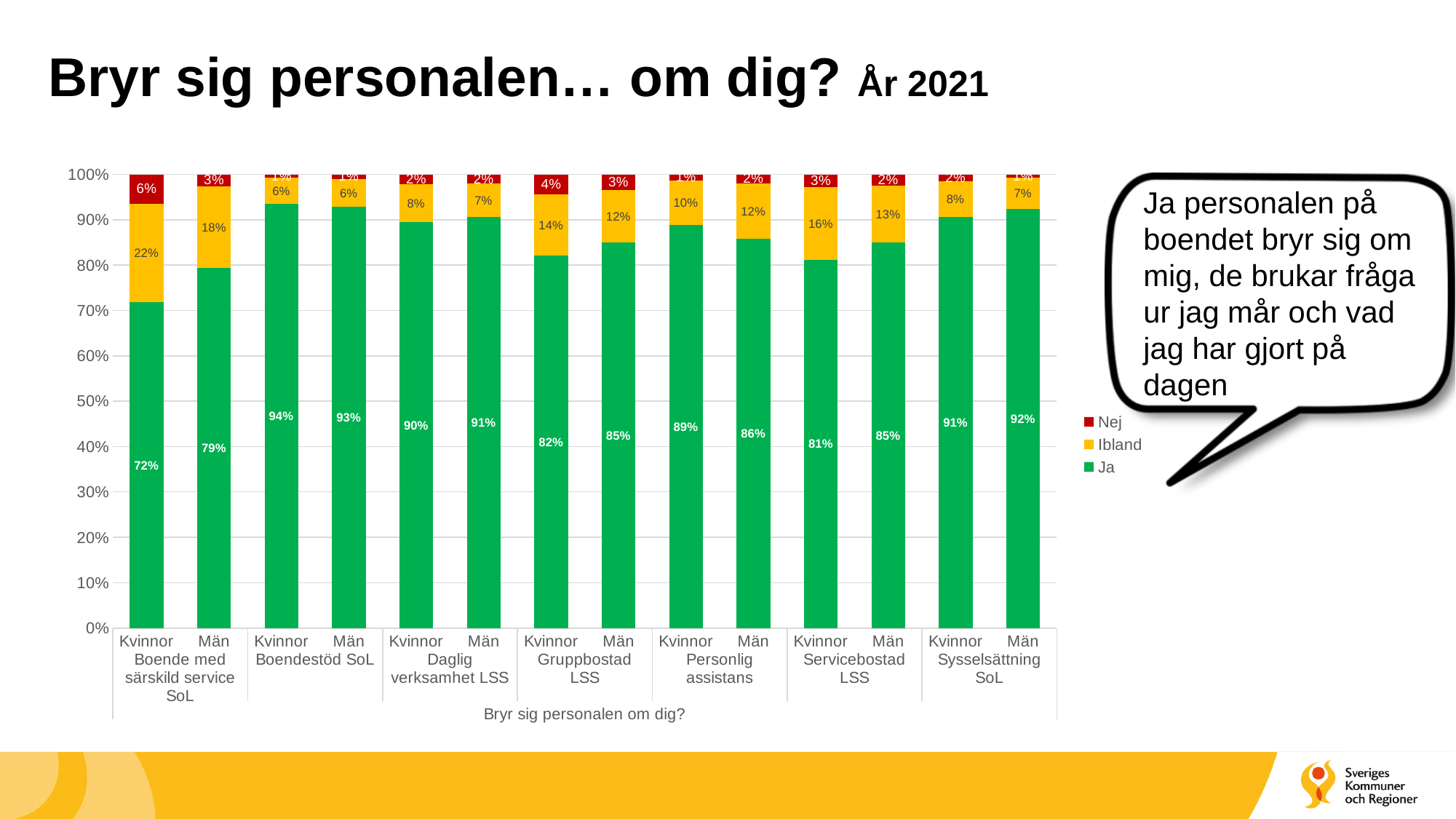
How many bars are plotted in the chart? 14 Which bar has the highest 'Ja' value? Kvinnor, Boendestöd SoL (94%) What kind of chart is shown on the slide? Stacked bar chart What are the three series named in the legend? Nej, Ibland, Ja What is the 'Ja' value for Män in Sysselsättning SoL? 92% What is the 'Nej' value for Kvinnor in Boende med särskild service SoL? 6% Which has a larger 'Ibland' value: Kvinnor in Servicebostad LSS or Kvinnor in Personlig assistans? Kvinnor in Servicebostad LSS What is the difference between the 'Ja' values for Män and Kvinnor in Servicebostad LSS? 4 percentage points What is the 'Ja' value for Kvinnor in Boende med särskild service SoL? 72% What is the 'Ibland' value for Män in Gruppbostad LSS? 12% Which bar has the lowest 'Ja' value? Kvinnor, Boende med särskild service SoL (72%) How many series does the legend list? 3